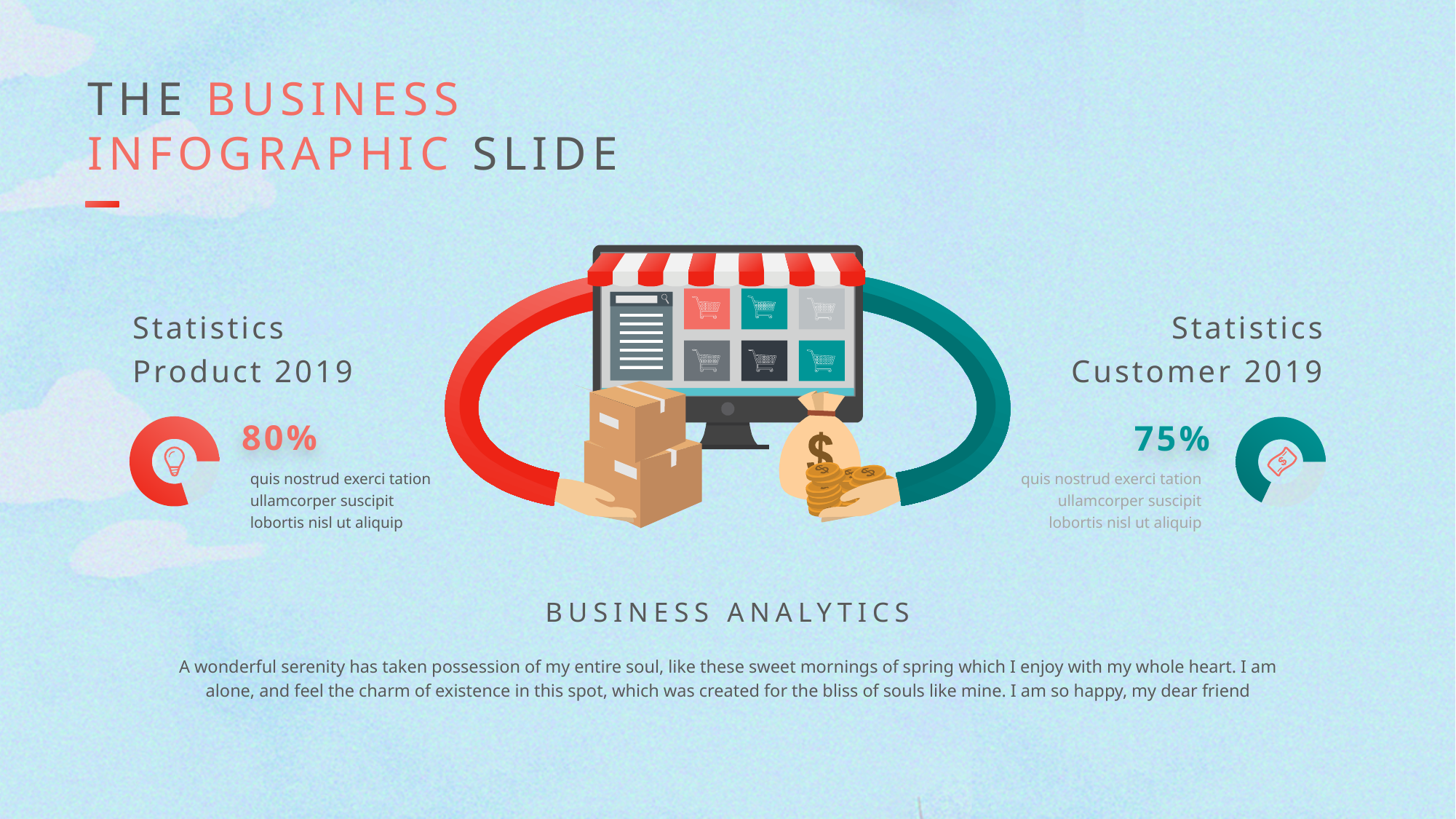
What percentage is shown for Statistics Product 2019? 80% Which of the two statistics shown has the highest percentage? Statistics Product 2019 What kind of chart is used to display the Statistics Product 2019 value? Donut chart How many donut charts are shown on the slide? 2 What percentage is shown for Statistics Customer 2019? 75% What colour is the donut chart for Statistics Customer 2019? Teal Which is higher, the Statistics Product 2019 value or the Statistics Customer 2019 value? Statistics Product 2019 What is the difference between the Statistics Product 2019 percentage and the Statistics Customer 2019 percentage? 5% Is the Statistics Customer 2019 value greater or less than 50%? greater Which of the two statistics shown has the lowest percentage? Statistics Customer 2019 What colour is the donut chart for Statistics Product 2019? Red